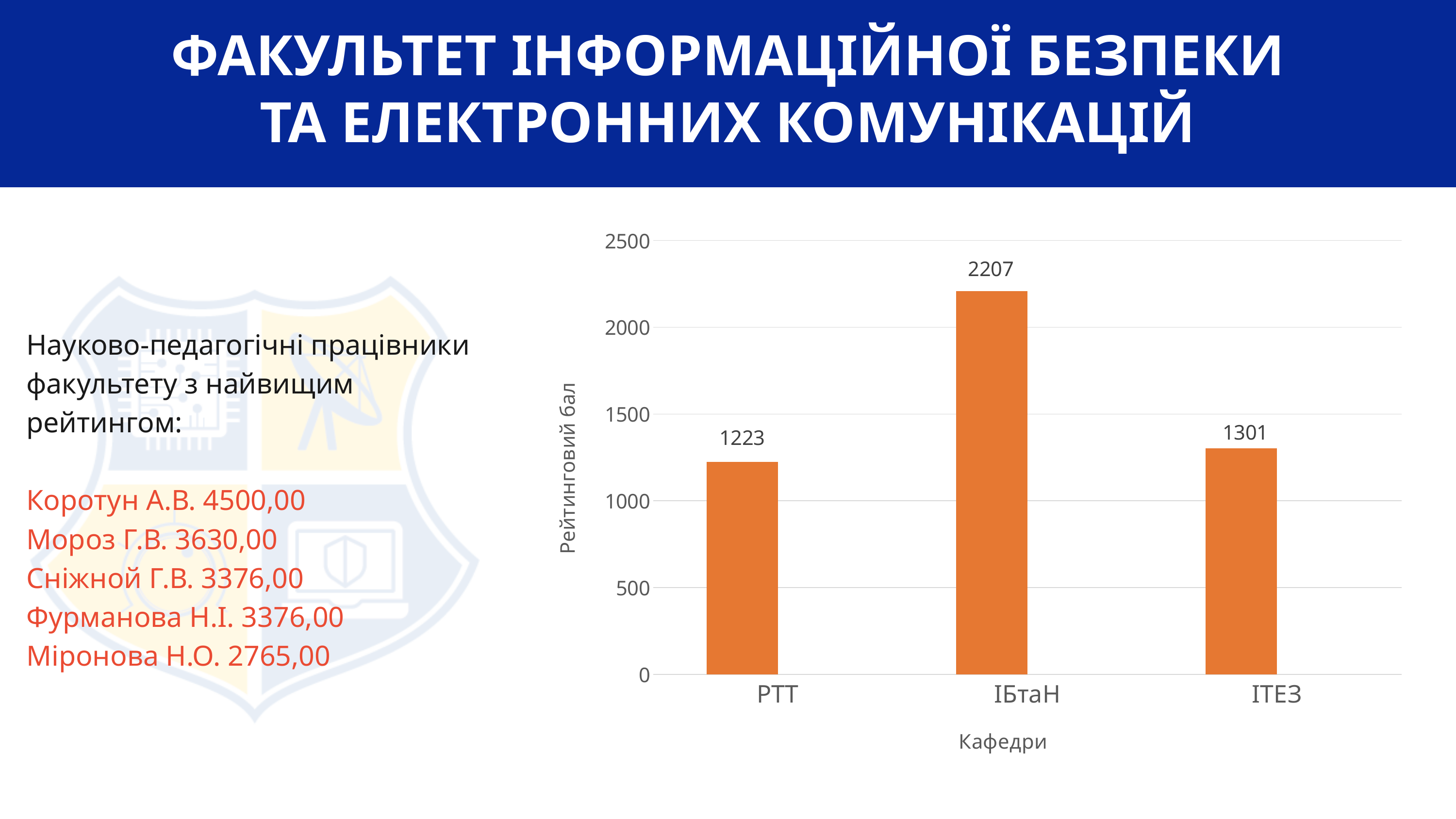
Is the value for ІБтаН greater or less than 2000? greater What is the rating score for ІБтаН? 2207 What is the difference between the rating scores of ІТЕЗ and РТТ? 78 Which has a higher rating score, ІТЕЗ or РТТ? ІТЕЗ What is the difference between the rating scores of ІБтаН and РТТ? 984 What is the rating score (Рейтинговий бал) for РТТ? 1223 What kind of chart is shown on the slide? bar chart How many departments are shown on the chart? 3 Which department has the lowest rating score? РТТ Which department (кафедра) has the highest rating score? ІБтаН What is the label of the x axis of the chart? Кафедри What is the rating score for ІТЕЗ? 1301